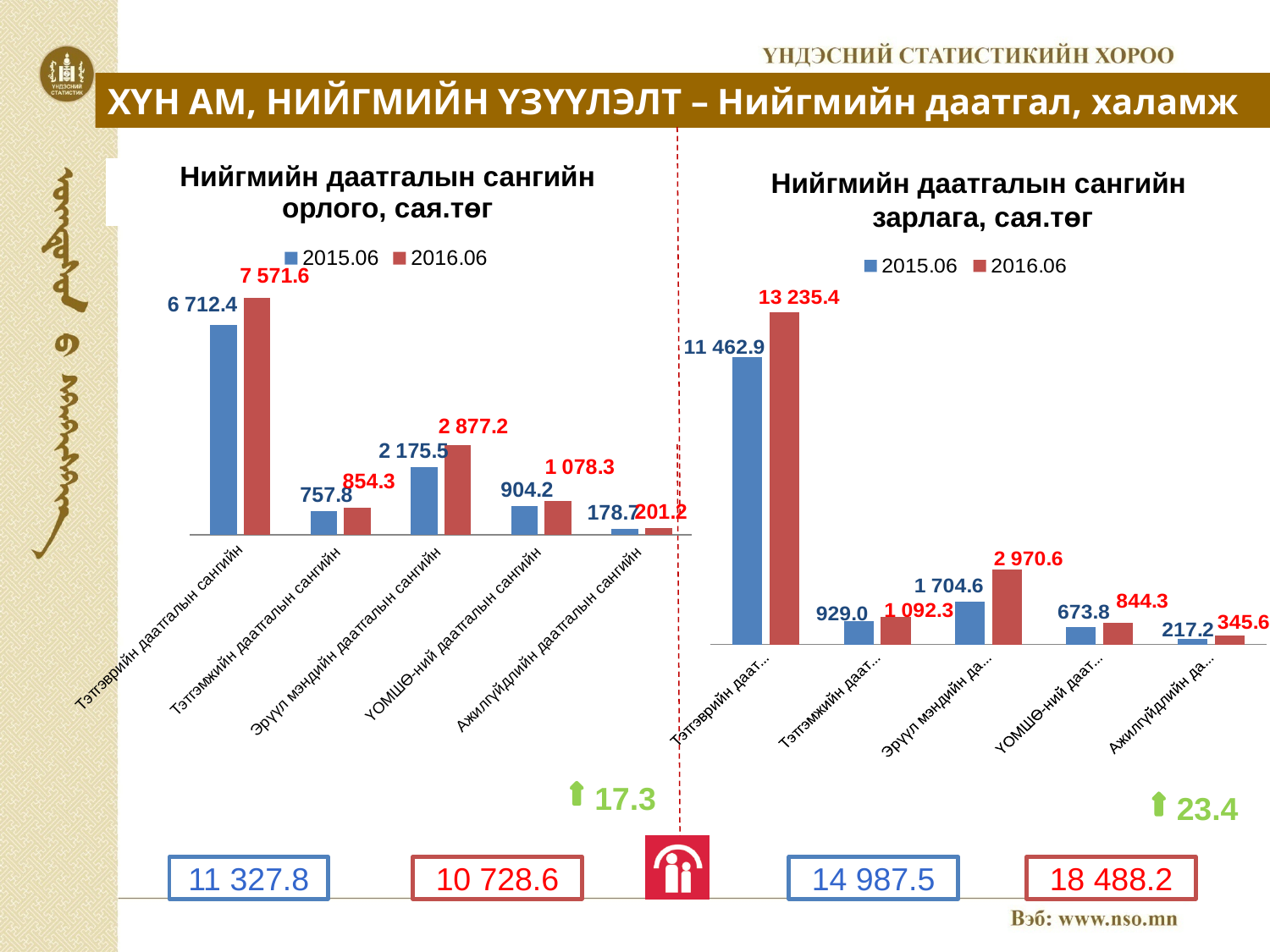
In the chart 'Нийгмийн даатгалын сангийн зарлага, сая.төг', what is the 2015.06 value for Ажилгүйдлийн даатгалын сангийн? 217.2 In the chart 'Нийгмийн даатгалын сангийн орлого, сая.төг', which is larger for ҮОМШӨ-ний даатгалын сангийн: the 2015.06 value or the 2016.06 value? 2016.06 In the chart 'Нийгмийн даатгалын сангийн орлого, сая.төг', what is the difference between the 2016.06 and 2015.06 values for Тэтгэврийн даатгалын сангийн? 859.2 How many categories are shown on the x axis of the chart 'Нийгмийн даатгалын сангийн зарлага, сая.төг'? 5 How many series does the legend of the chart 'Нийгмийн даатгалын сангийн орлого, сая.төг' list? 2 In the chart 'Нийгмийн даатгалын сангийн орлого, сая.төг', what is the 2016.06 value for Тэтгэврийн даатгалын сангийн? 7 571.6 In the chart 'Нийгмийн даатгалын сангийн зарлага, сая.төг', what is the difference between the 2016.06 and 2015.06 values for Эрүүл мэндийн даатгалын сангийн? 1 266.0 In the chart 'Нийгмийн даатгалын сангийн орлого, сая.төг', which category has the lowest 2016.06 value? Ажилгүйдлийн даатгалын сангийн In the chart 'Нийгмийн даатгалын сангийн орлого, сая.төг', what is the 2015.06 value for Эрүүл мэндийн даатгалын сангийн? 2 175.5 In the chart 'Нийгмийн даатгалын сангийн зарлага, сая.төг', which category has the highest 2015.06 value? Тэтгэврийн даатгалын сангийн What kind of chart is 'Нийгмийн даатгалын сангийн зарлага, сая.төг'? Bar chart In the chart 'Нийгмийн даатгалын сангийн зарлага, сая.төг', what is the 2016.06 value for Тэтгэврийн даатгалын сангийн? 13 235.4